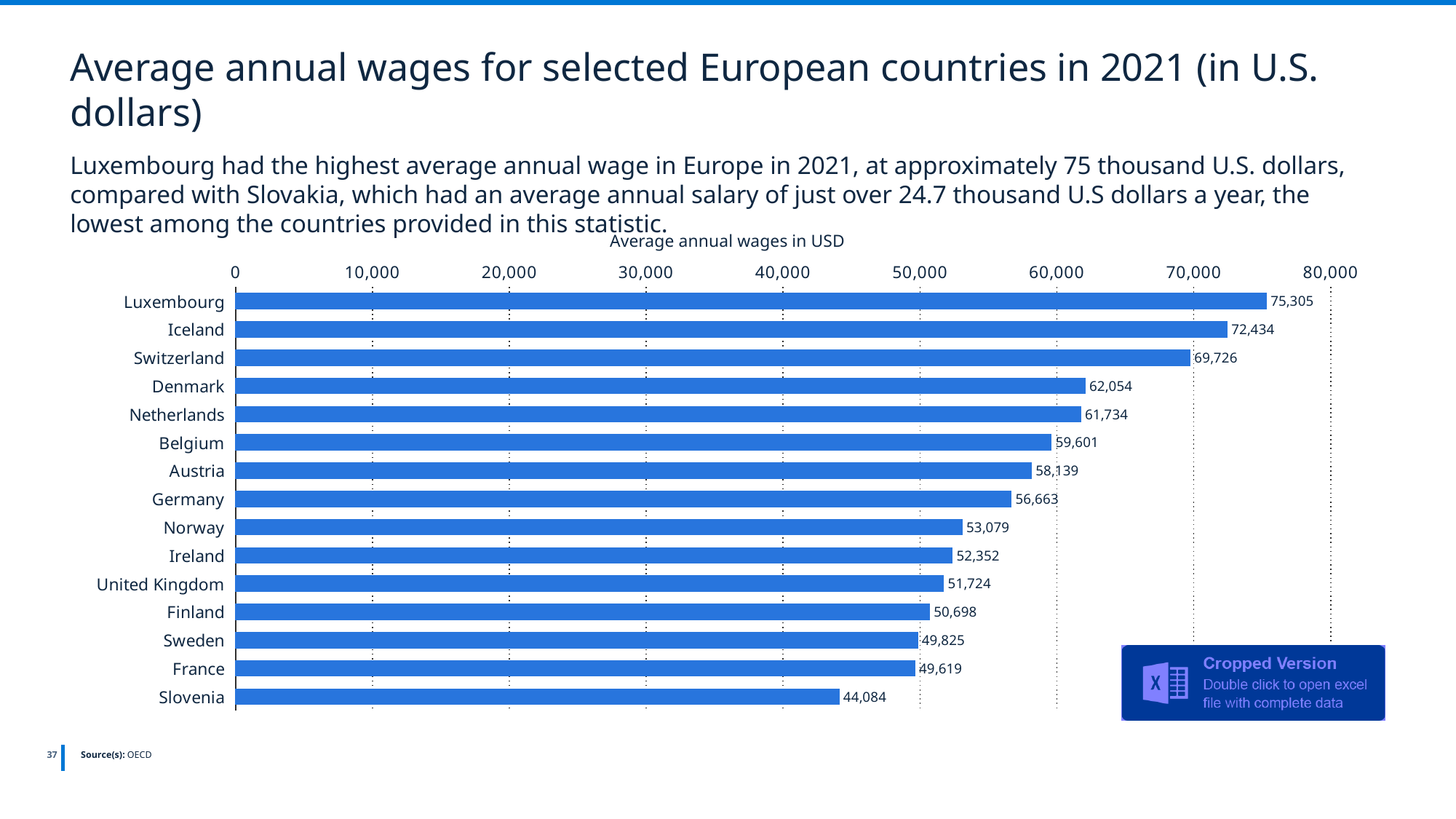
What kind of chart is shown on the slide? Bar chart What is the average annual wage shown for Luxembourg? 75,305 What is the difference between the average annual wages of Luxembourg and Iceland? 2,871 What is the title of the chart? Average annual wages in USD What is the average annual wage shown for Germany? 56,663 Which country has the highest average annual wage in the chart? Luxembourg What is the average annual wage shown for Slovenia? 44,084 Which country has the lowest average annual wage in the chart? Slovenia How many countries are shown in the chart? 15 What is the difference between the average annual wages of Denmark and the Netherlands? 320 Is the value for Switzerland greater or less than 70,000? less Which has a higher average annual wage, Norway or Ireland? Norway